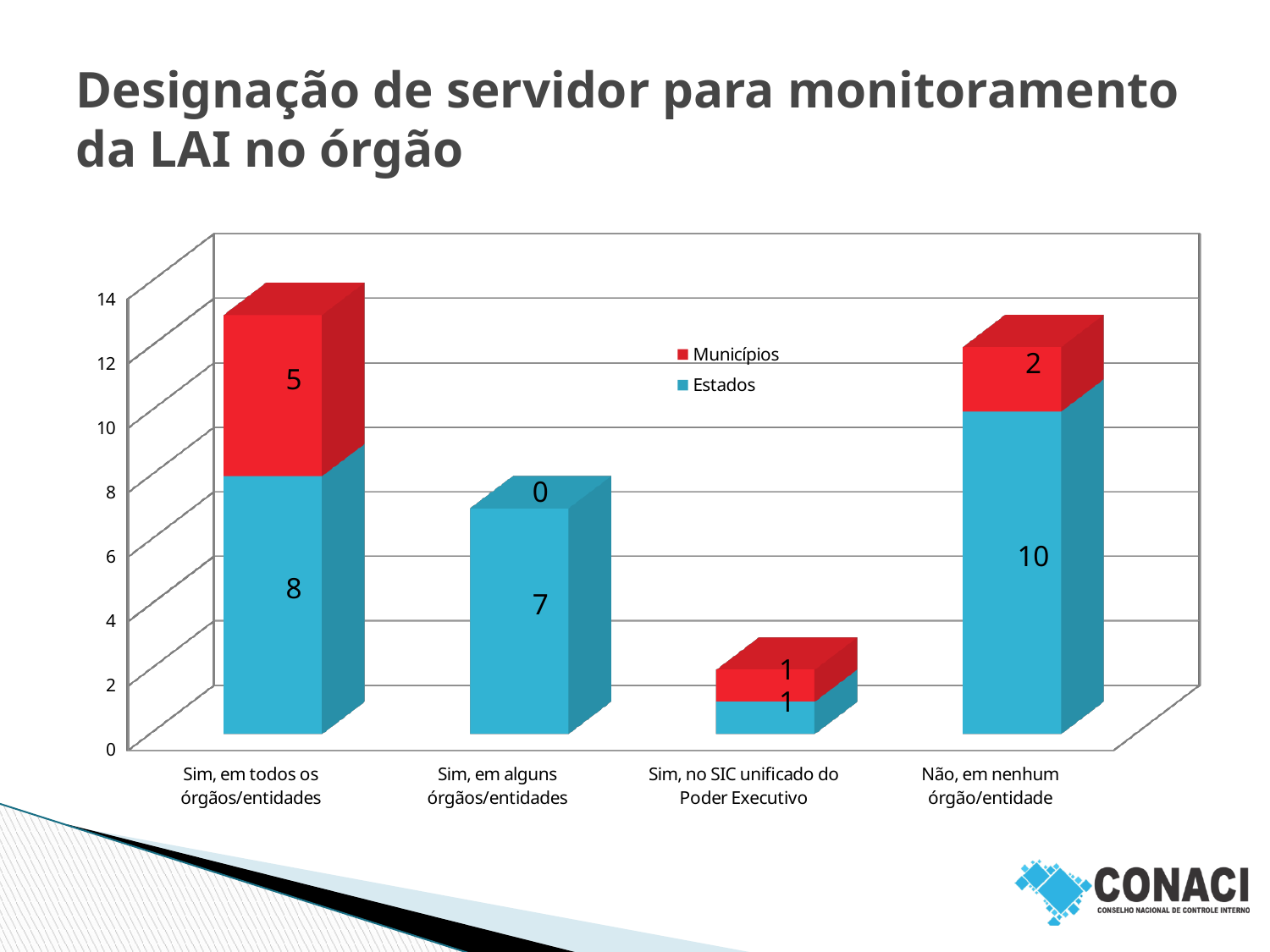
What is the value for Estados in the category "Sim, em todos os órgãos/entidades"? 8 Which category has the lowest value for Municípios? Sim, em alguns órgãos/entidades What is the value for Estados in the category "Sim, no SIC unificado do Poder Executivo"? 1 What is the total of the stacked bar for "Sim, em todos os órgãos/entidades"? 13 What is the value for Municípios in the category "Não, em nenhum órgão/entidade"? 2 Which is larger: the Municípios value for "Sim, em todos os órgãos/entidades" or the Municípios value for "Não, em nenhum órgão/entidade"? Sim, em todos os órgãos/entidades What is the value for Municípios in the category "Sim, em alguns órgãos/entidades"? 0 How many categories are shown on the x axis? 4 What is the total of the stacked bar for "Não, em nenhum órgão/entidade"? 12 What is the difference between the Estados value and the Municípios value in the category "Sim, em todos os órgãos/entidades"? 3 Which category has the highest value for Estados? Não, em nenhum órgão/entidade How many series does the legend list? 2